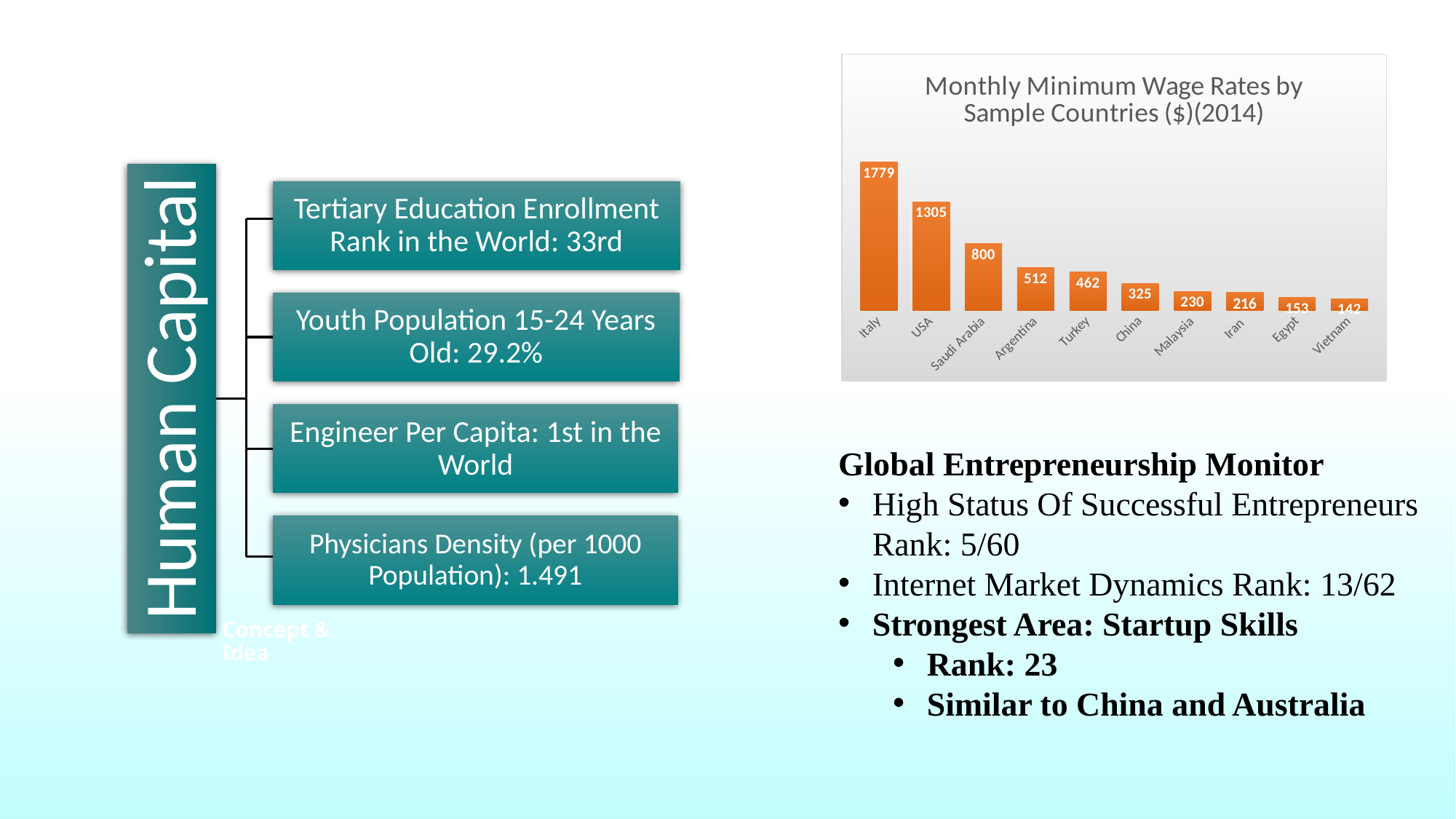
Which has a higher monthly minimum wage rate, Malaysia or Iran? Malaysia What kind of chart is used to show the monthly minimum wage rates? Bar chart What is the difference between the monthly minimum wage rates of Italy and the USA? 474 Which country has the lowest monthly minimum wage rate in the chart? Vietnam What is the monthly minimum wage rate shown for Italy? 1779 Which country has the highest monthly minimum wage rate in the chart? Italy What is the difference between the monthly minimum wage rates of Argentina and China? 187 What is the title of the chart on the slide? Monthly Minimum Wage Rates by Sample Countries ($)(2014) What is the monthly minimum wage rate shown for Turkey? 462 How many countries are shown in the chart? 10 Do the values rise or fall from left to right across the chart? Fall What is the monthly minimum wage rate shown for Saudi Arabia? 800